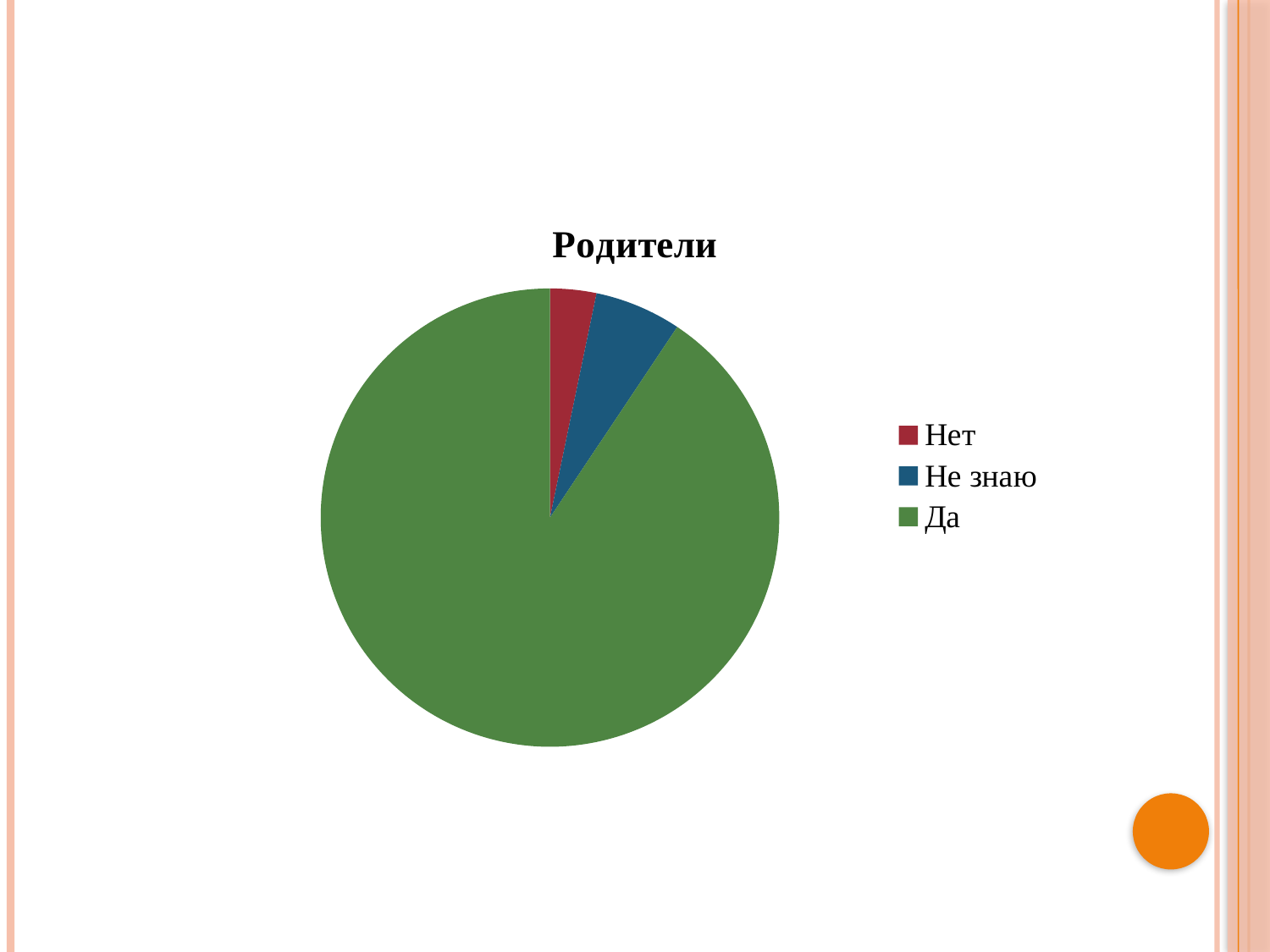
What colour is the slice for "Да"? green Which slice is larger, "Да" or "Не знаю"? Да Which category is shown in blue? Не знаю Which slice is larger, "Не знаю" or "Нет"? Не знаю Which category has the largest slice of the pie? Да Which category has the smallest slice of the pie? Нет How many categories does the legend list? 3 What kind of chart is shown on the slide? pie chart What is the title of the chart? Родители